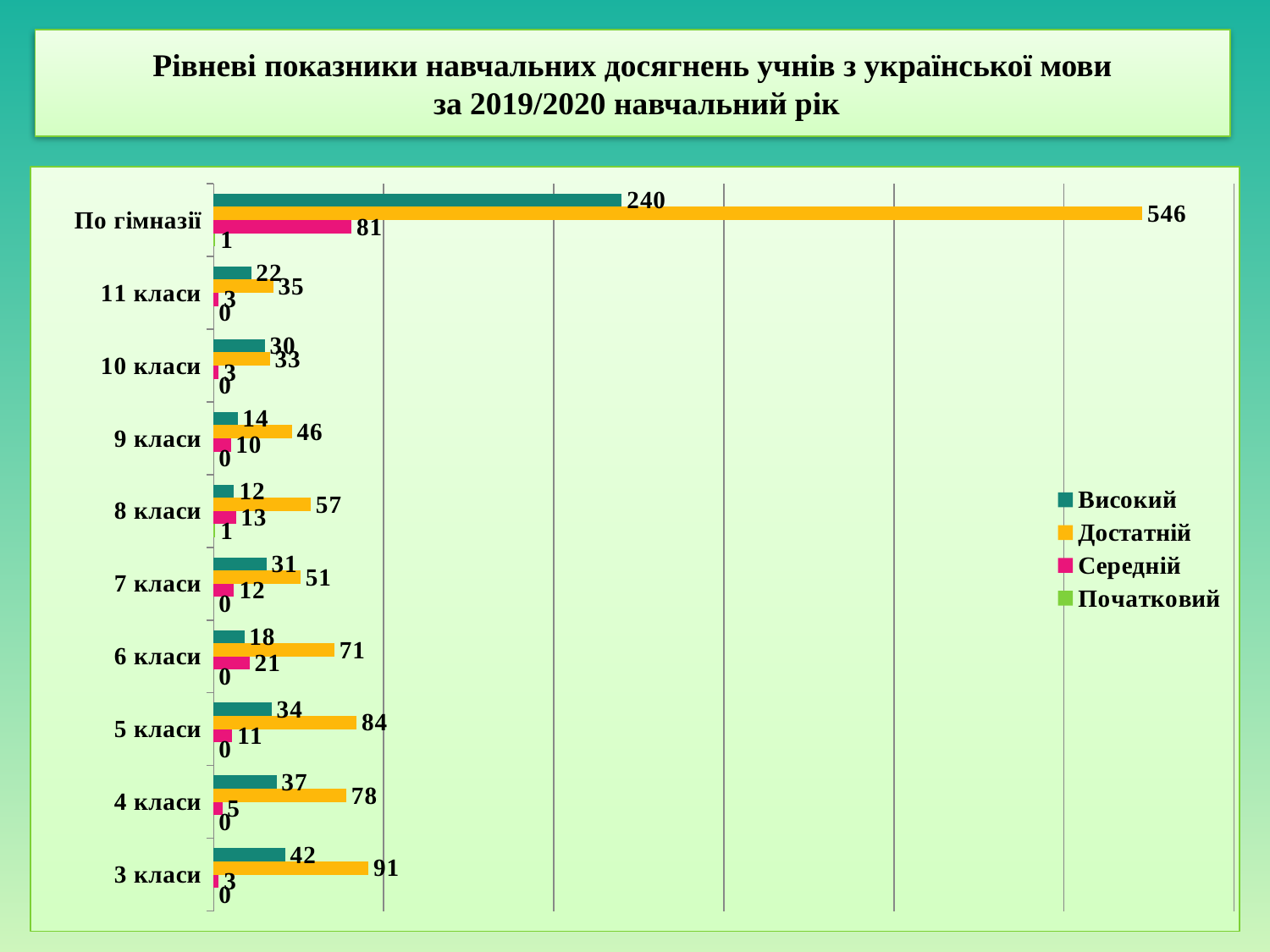
Among the class groups (excluding По гімназії), which category has the lowest Високий value? 8 класи How many categories are shown on the chart? 10 What is the value for Середній for 6 класи? 21 Which is larger: the Високий value for 7 класи or the Високий value for 6 класи? 7 класи What is the difference between the Достатній values for 5 класи and 4 класи? 6 How many series does the legend list? 4 What kind of chart is shown on the slide? Bar chart What is the value for Високий for 3 класи? 42 Among the class groups (excluding По гімназії), which category has the highest Достатній value? 3 класи What is the value for Достатній for По гімназії? 546 What is the value for Початковий for 8 класи? 1 Which series is shown in orange in the legend? Достатній